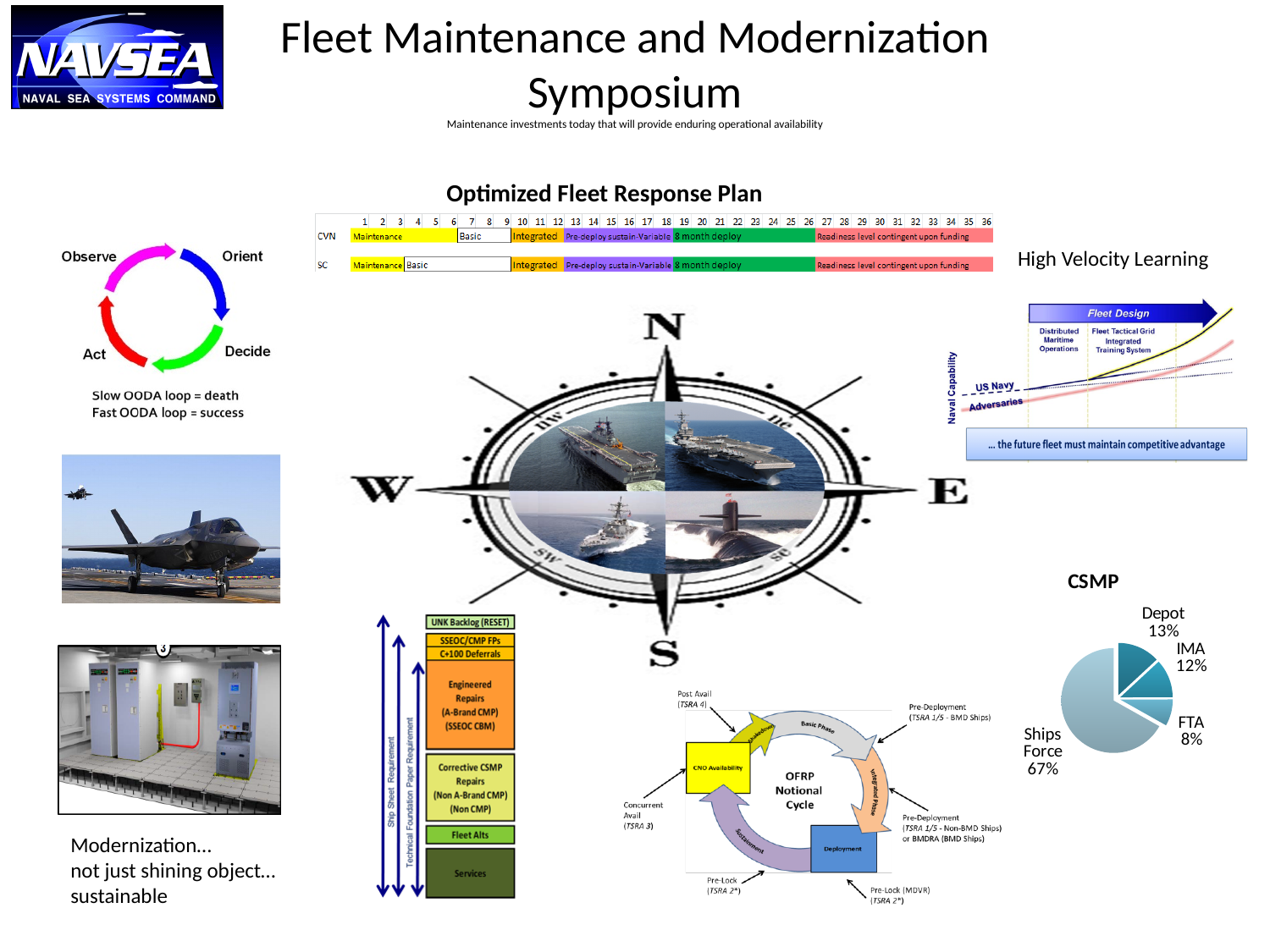
What is the title of the pie chart on the slide? CSMP In the CSMP pie chart, what is the difference between the Ships Force share and the Depot share? 54% In the CSMP pie chart, what share does IMA have? 12% In the CSMP pie chart, what share does FTA have? 8% In the CSMP pie chart, which is larger, Depot or FTA? Depot In the CSMP pie chart, which category has the smallest share? FTA In the CSMP pie chart, what share does Ships Force have? 67% In the CSMP pie chart, what is the difference between the Depot share and the FTA share? 5% In the CSMP pie chart, what share does Depot have? 13% What kind of chart is the CSMP chart? pie chart In the CSMP pie chart, how many slices are there? 4 In the CSMP pie chart, which category has the largest share? Ships Force